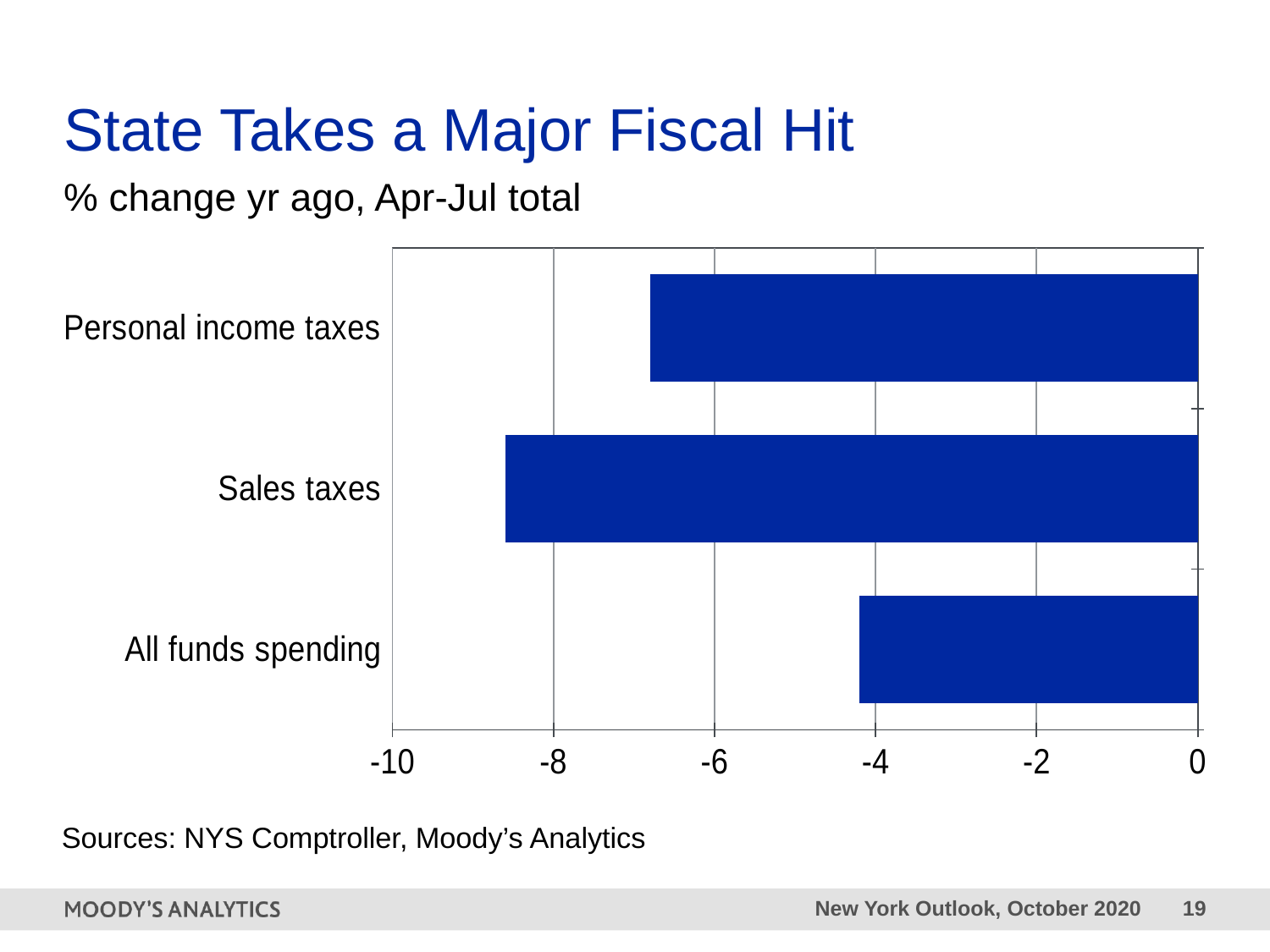
What kind of chart is shown on the slide? Bar chart What is the title of the slide? State Takes a Major Fiscal Hit Which category shows the smallest decline (highest value)? All funds spending Is the value for Sales taxes greater or less than -8? less How many categories are plotted in the chart? 3 Is the value for All funds spending greater or less than -6? greater Which category has a larger decline, Sales taxes or Personal income taxes? Sales taxes Which category has a larger decline, Personal income taxes or All funds spending? Personal income taxes Which category shows the largest decline (lowest value)? Sales taxes Is the value for All funds spending greater or less than -2? less What unit or measure does the chart subtitle say the values represent? % change yr ago, Apr-Jul total